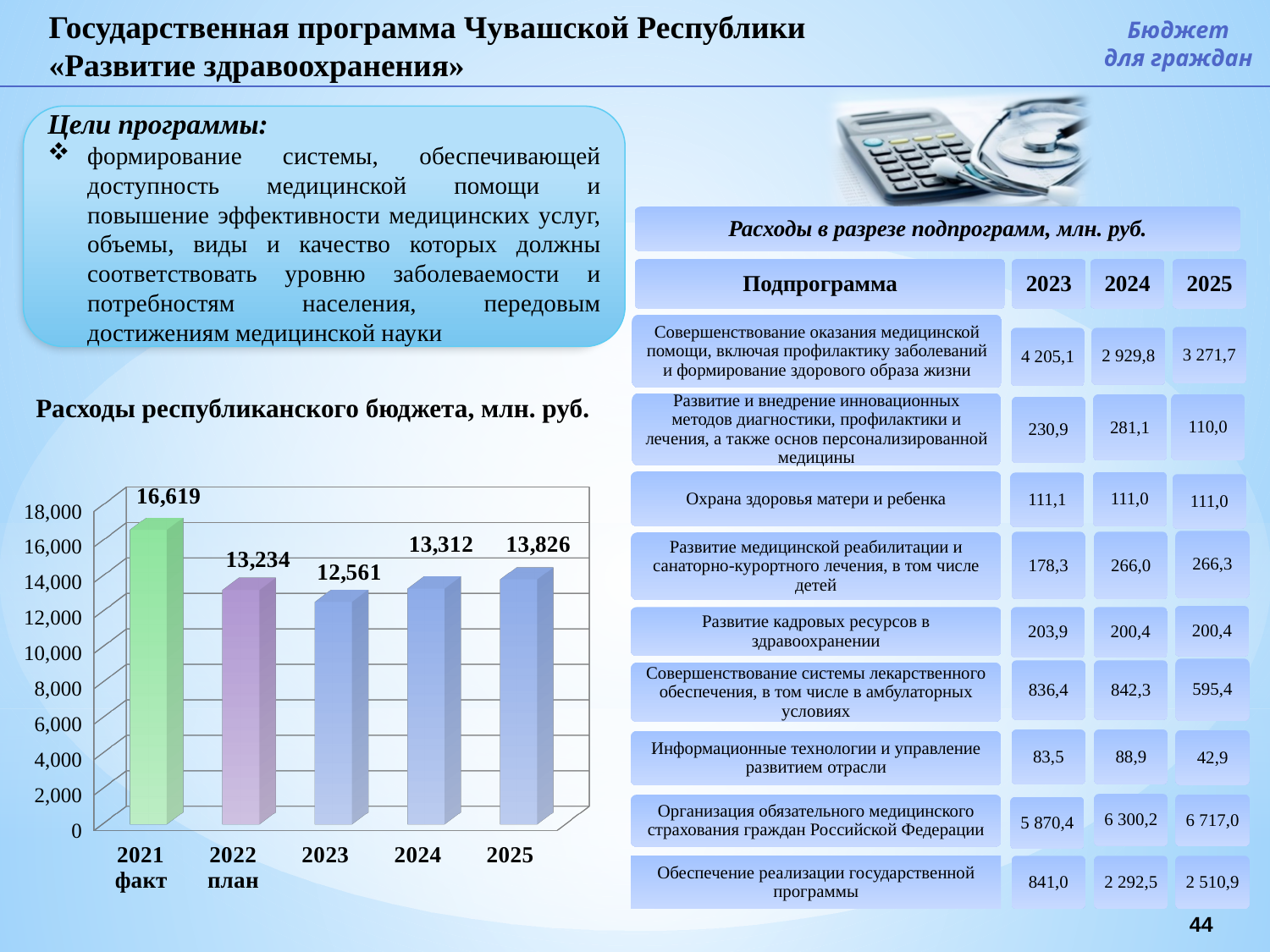
Is the value for 2023 in the chart 'Расходы республиканского бюджета, млн. руб.' greater or less than 14,000? less Which year has the highest value in the chart 'Расходы республиканского бюджета, млн. руб.'? 2021 факт What is the value for 2025 in the chart 'Расходы республиканского бюджета, млн. руб.'? 13,826 What kind of chart is 'Расходы республиканского бюджета, млн. руб.'? bar chart Which is larger in the chart 'Расходы республиканского бюджета, млн. руб.': the value for 2022 план or the value for 2024? 2024 How many years are shown on the x axis of the chart 'Расходы республиканского бюджета, млн. руб.'? 5 Which year has the lowest value in the chart 'Расходы республиканского бюджета, млн. руб.'? 2023 What is the difference between the 2021 факт and 2022 план values in the chart 'Расходы республиканского бюджета, млн. руб.'? 3,385 Do the values in the chart 'Расходы республиканского бюджета, млн. руб.' rise or fall from 2023 to 2025? rise What is the value for 2021 факт in the chart 'Расходы республиканского бюджета, млн. руб.'? 16,619 What is the value for 2023 in the chart 'Расходы республиканского бюджета, млн. руб.'? 12,561 What is the difference between the 2025 and 2024 values in the chart 'Расходы республиканского бюджета, млн. руб.'? 514